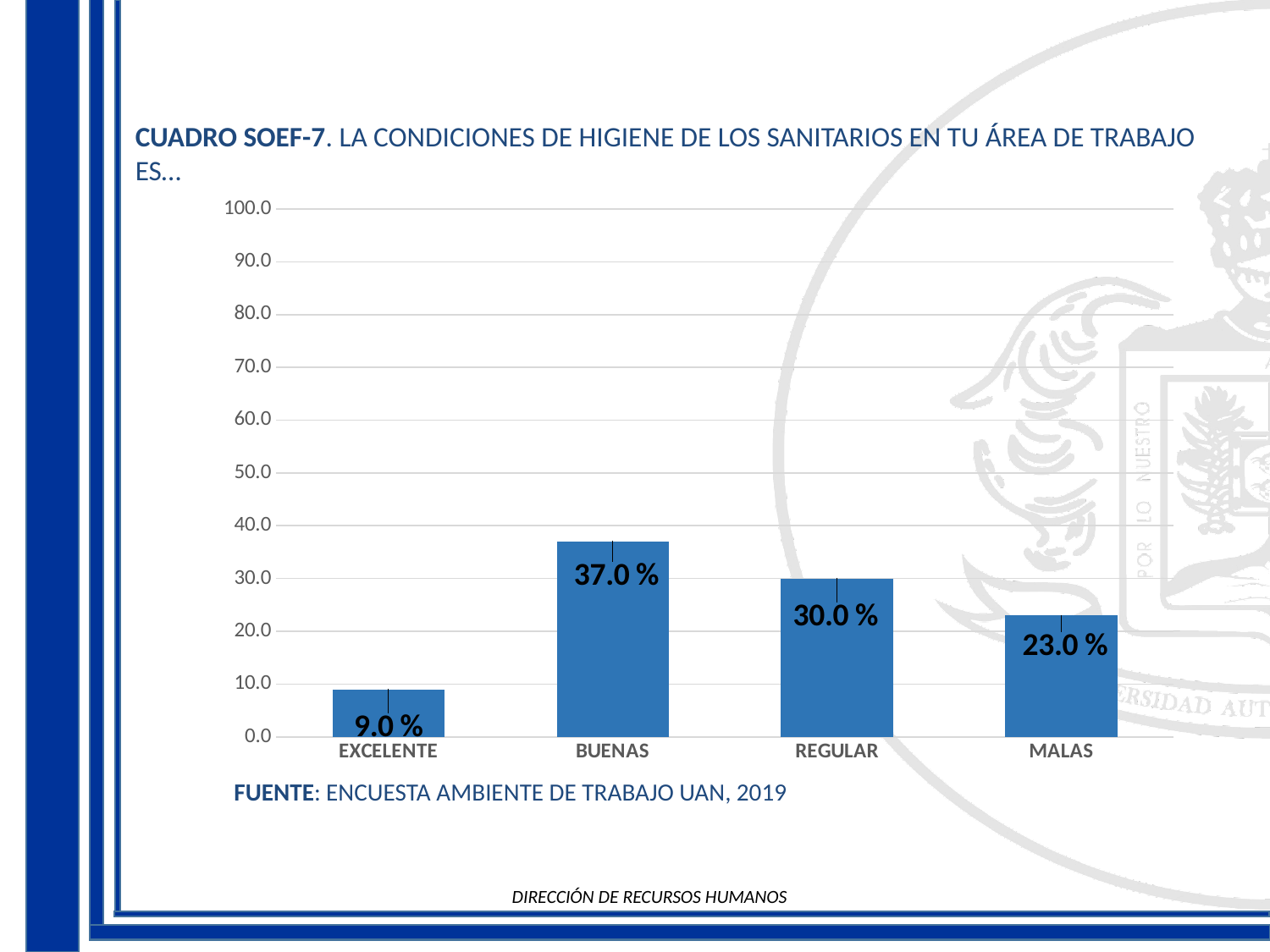
What is the difference between the values for BUENAS and REGULAR? 7.0 % What is the value for MALAS? 23.0 % What is the value for EXCELENTE? 9.0 % Which category has the highest value? BUENAS What is the value for BUENAS? 37.0 % How many categories are shown on the x axis? 4 Which is larger, the value for REGULAR or the value for MALAS? REGULAR Which category has the lowest value? EXCELENTE What kind of chart is shown on the slide? bar chart Is the value for MALAS greater or less than 20.0? greater What is the value for REGULAR? 30.0 % What source is cited below the chart? ENCUESTA AMBIENTE DE TRABAJO UAN, 2019